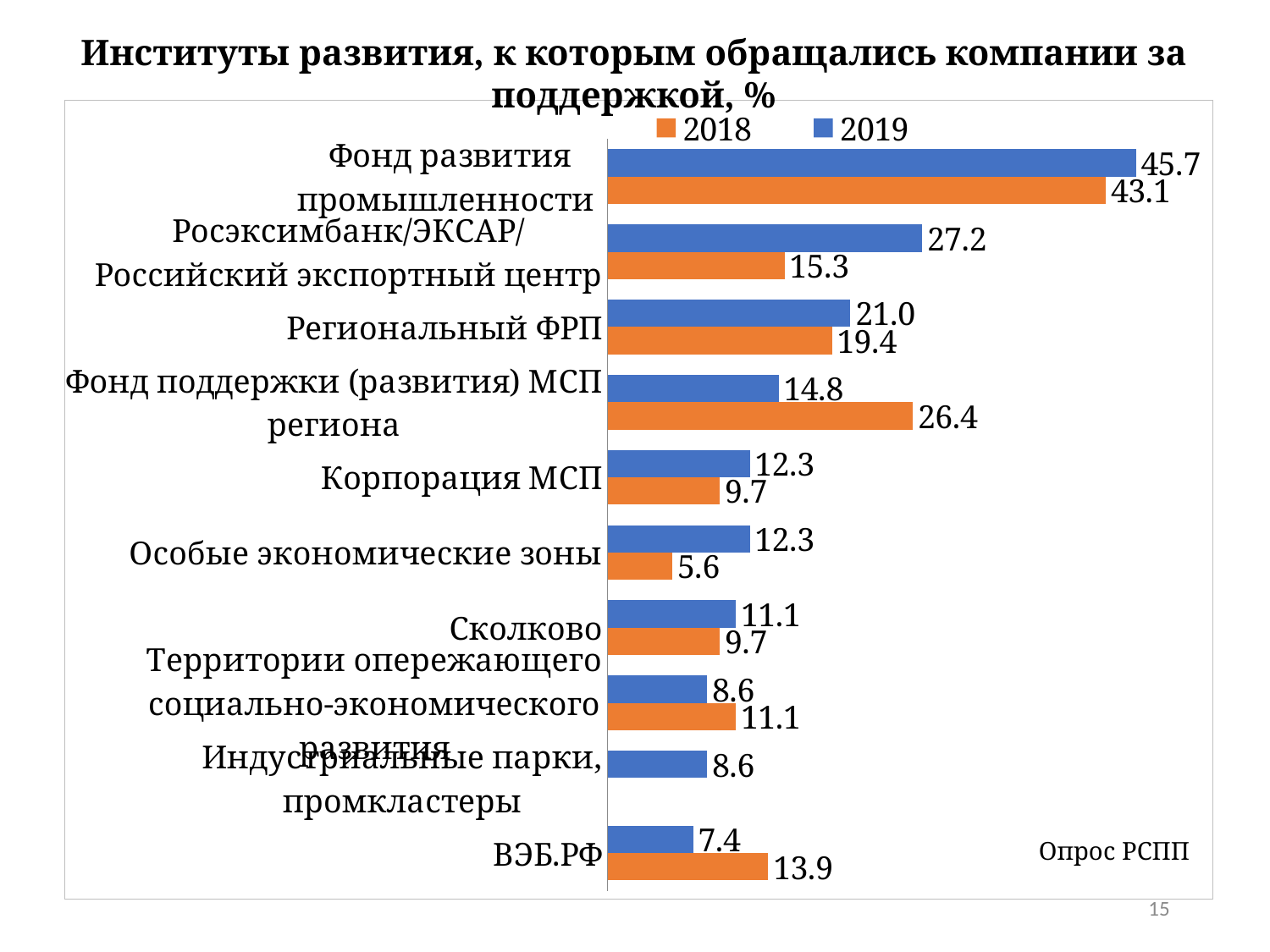
How many categories (development institutions) are shown on the chart? 10 What type of chart is shown on the slide? bar chart What is the 2018 value for Росэксимбанк/ЭКСАР/Российский экспортный центр? 15.3 What is the 2018 value for ВЭБ.РФ? 13.9 What is the 2019 value for Фонд развития промышленности? 45.7 What is the difference between the 2018 and 2019 values for ВЭБ.РФ? 6.5 Which colour represents the 2019 series in the chart? blue What is the difference between the 2019 and 2018 values for Росэксимбанк/ЭКСАР/Российский экспортный центр? 11.9 How many series does the legend list? 2 Which category has the lowest 2018 value? Особые экономические зоны Which category has the highest 2019 value? Фонд развития промышленности For Фонд поддержки (развития) МСП региона, which year has the larger value, 2018 or 2019? 2018